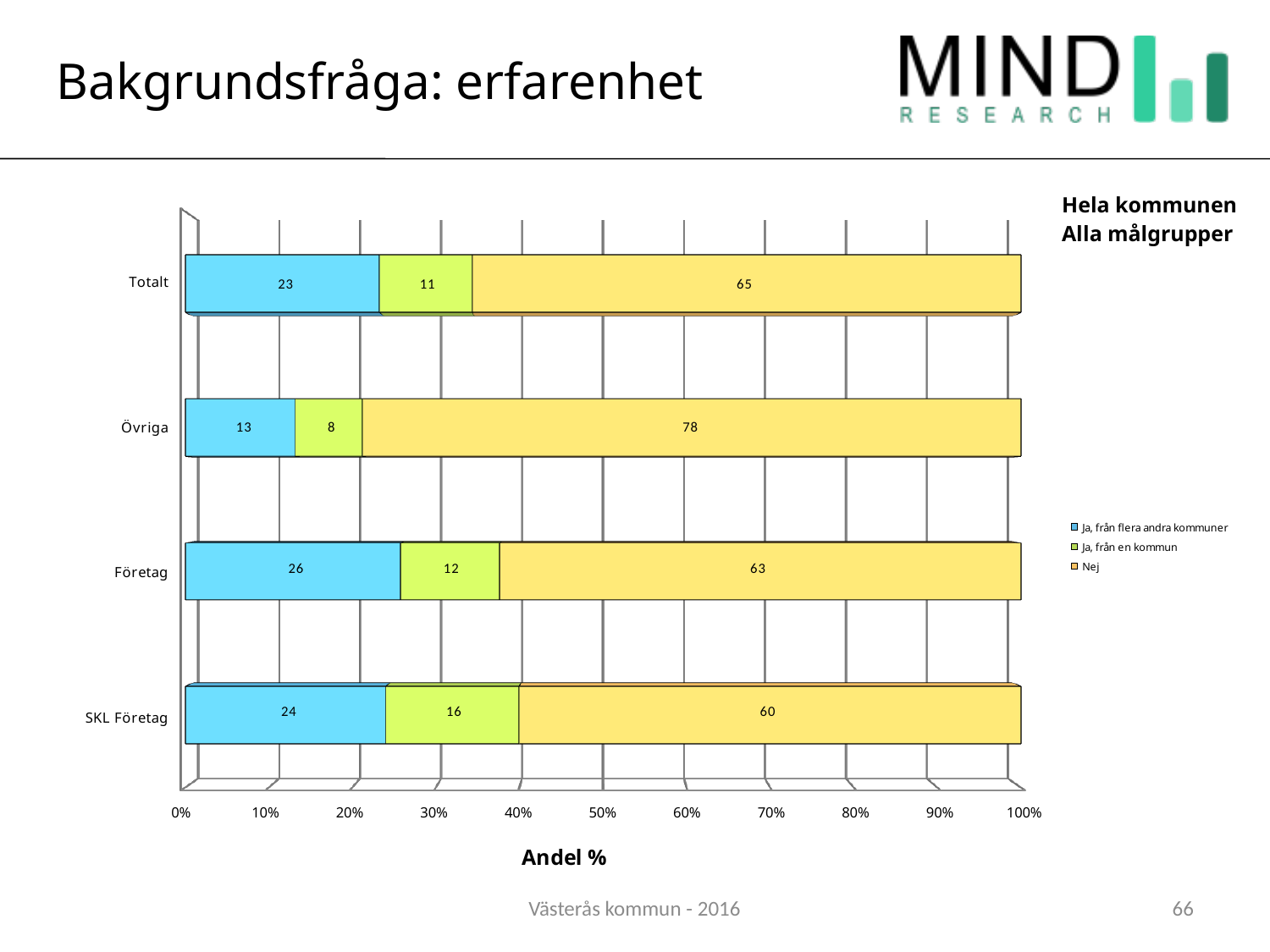
What is the value for "Nej" in the Övriga category? 78 Which is larger: the "Ja, från en kommun" value for Totalt or for Företag? Företag What is the total of the stacked bar for Totalt? 99 What is the difference between the "Nej" values for Övriga and SKL Företag? 18 Which category has the highest value for "Nej"? Övriga What is the value for "Ja, från en kommun" in the SKL Företag category? 16 What kind of chart is shown on the slide? Stacked bar chart How many series does the legend list? 3 What is the value for "Ja, från flera andra kommuner" in the Företag category? 26 How many categories are shown on the y axis? 4 Which category has the lowest value for "Ja, från flera andra kommuner"? Övriga What is the x-axis title of the chart? Andel %